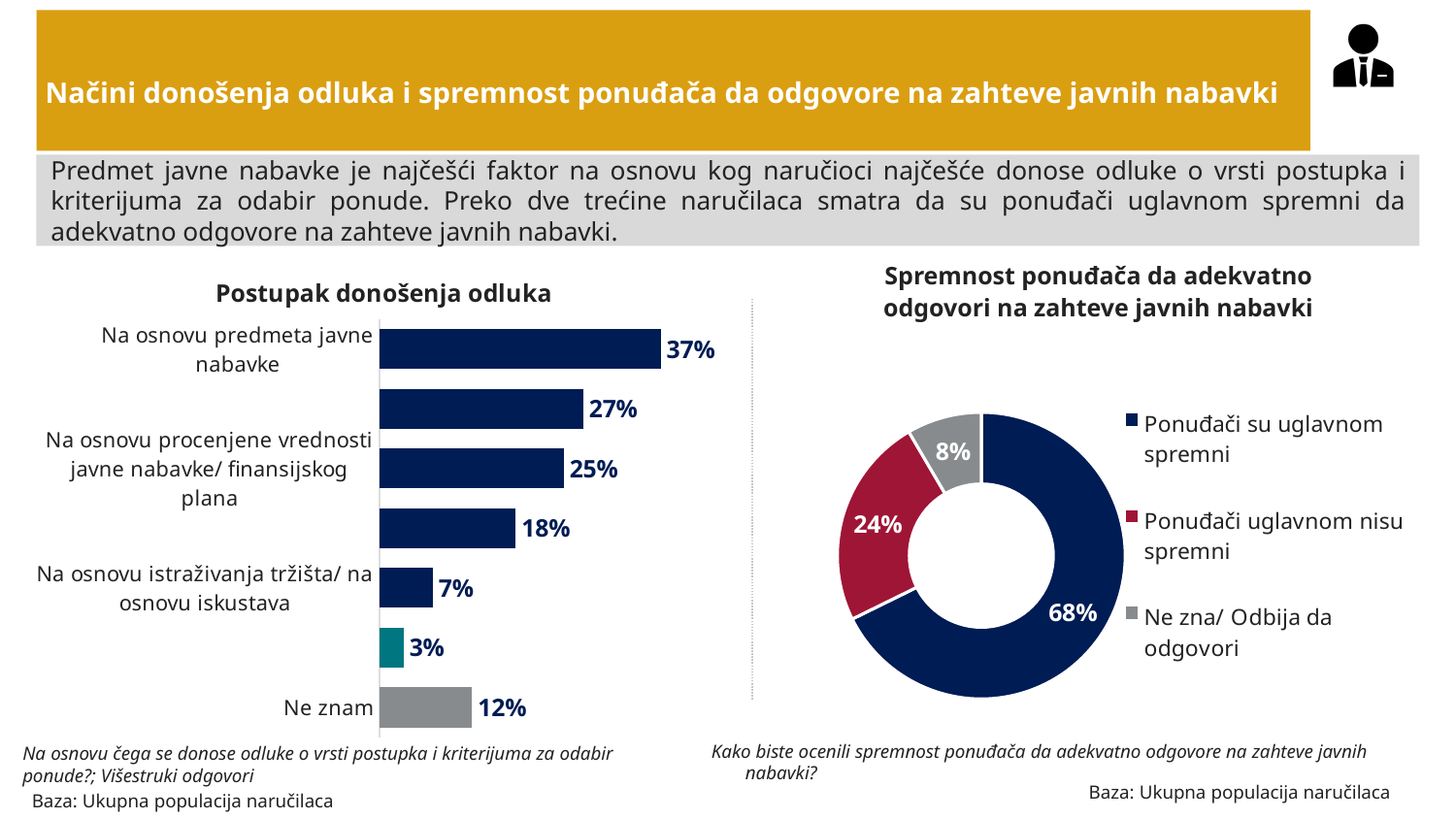
In the chart 'Spremnost ponuđača da adekvatno odgovori na zahteve javnih nabavki', what share is 'Ponuđači uglavnom nisu spremni'? 24% In the chart 'Spremnost ponuđača da adekvatno odgovori na zahteve javnih nabavki', what is the difference between 'Ponuđači su uglavnom spremni' and 'Ponuđači uglavnom nisu spremni'? 44 percentage points In the chart 'Postupak donošenja odluka', what is the difference between 'Na osnovu predmeta javne nabavke' and 'Ne znam'? 25 percentage points In the chart 'Postupak donošenja odluka', which category has the highest value? Na osnovu predmeta javne nabavke In the chart 'Postupak donošenja odluka', how many bars are plotted? 7 What type of chart is 'Postupak donošenja odluka'? Bar chart In the chart 'Postupak donošenja odluka', what is the value for 'Na osnovu predmeta javne nabavke'? 37% In the chart 'Postupak donošenja odluka', which is larger: 'Ne znam' or 'Na osnovu istraživanja tržišta/ na osnovu iskustava'? Ne znam In the chart 'Postupak donošenja odluka', what is the value for 'Na osnovu istraživanja tržišta/ na osnovu iskustava'? 7% In the chart 'Spremnost ponuđača da adekvatno odgovori na zahteve javnih nabavki', how many entries does the legend list? 3 In the chart 'Postupak donošenja odluka', what is the value for 'Ne znam'? 12% In the chart 'Spremnost ponuđača da adekvatno odgovori na zahteve javnih nabavki', what share is 'Ponuđači su uglavnom spremni'? 68%